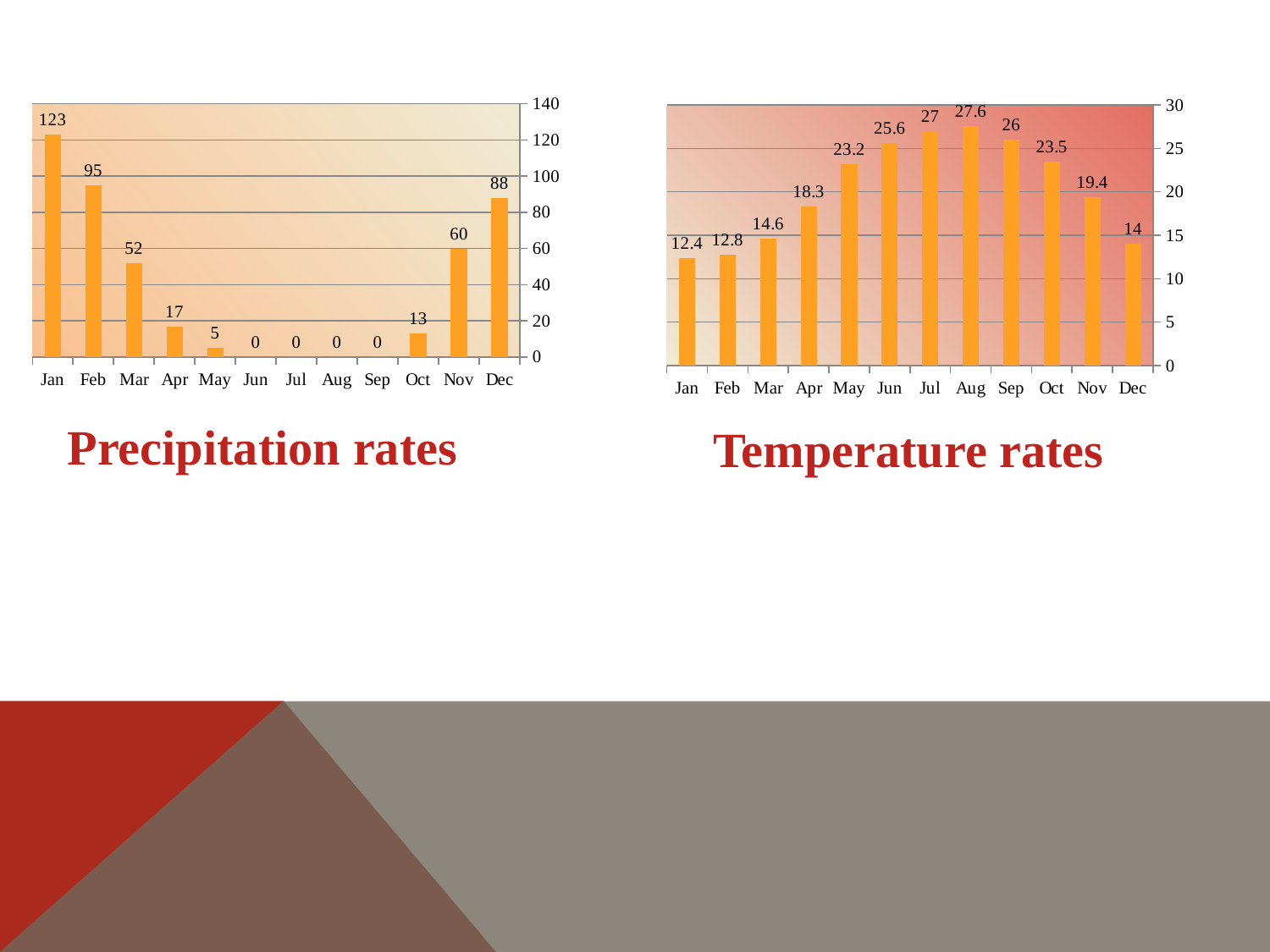
What is the title of the chart on the left side of the slide? Precipitation rates In the Precipitation rates chart, which month has the highest value? Jan In the Precipitation rates chart, what is the value for Jan? 123 In the Precipitation rates chart, how many months show a value of 0? 4 In the Temperature rates chart, what is the value for Aug? 27.6 In the Precipitation rates chart, which is larger, the value for Feb or the value for Dec? Feb In the Temperature rates chart, how many months are plotted? 12 In the Precipitation rates chart, what is the difference between the values for Nov and Oct? 47 In the Temperature rates chart, what is the difference between the values for Jul and Jan? 14.6 In the Temperature rates chart, do the values rise or fall from Jan to Aug? rise What kind of chart is the Temperature rates chart? bar chart In the Temperature rates chart, which month has the lowest value? Jan